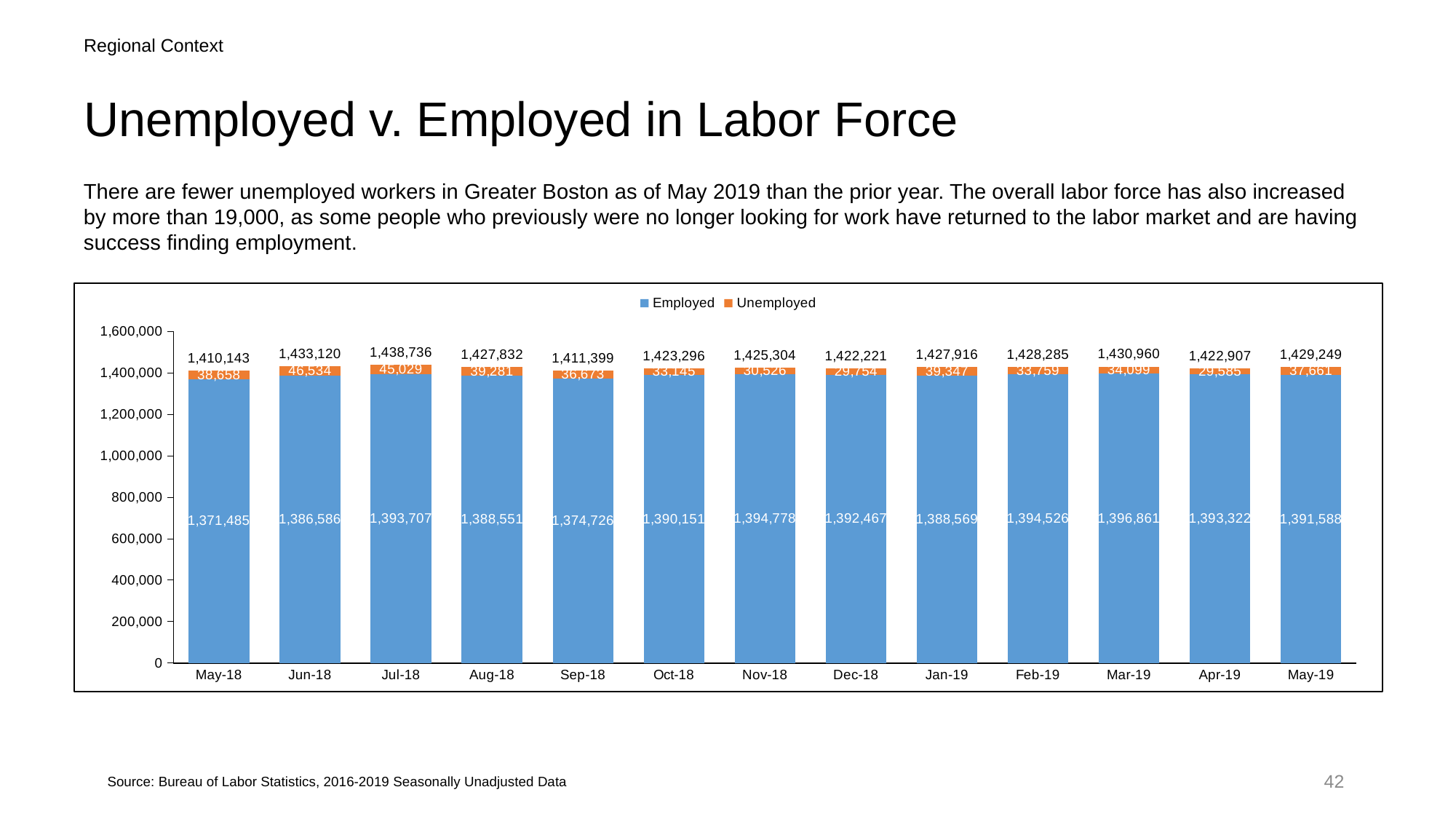
Which month has the lowest Unemployed value? Apr-19 Is the Employed value for Jun-18 larger than the Employed value for Sep-18? Yes How many months are shown on the x axis? 13 What is the difference between the Unemployed values for May-18 and May-19? 997 What is the total labor force (stacked bar total) for May-19? 1,429,249 Which month has the highest total labor force? Jul-18 What is the Employed value for Jul-18? 1,393,707 What is the Unemployed value for Dec-18? 29,754 What kind of chart is shown on the slide? Stacked bar chart Which month has the highest Unemployed value? Jun-18 How many series does the legend list? 2 Is the Employed value for Sep-18 greater or less than 1,400,000? less